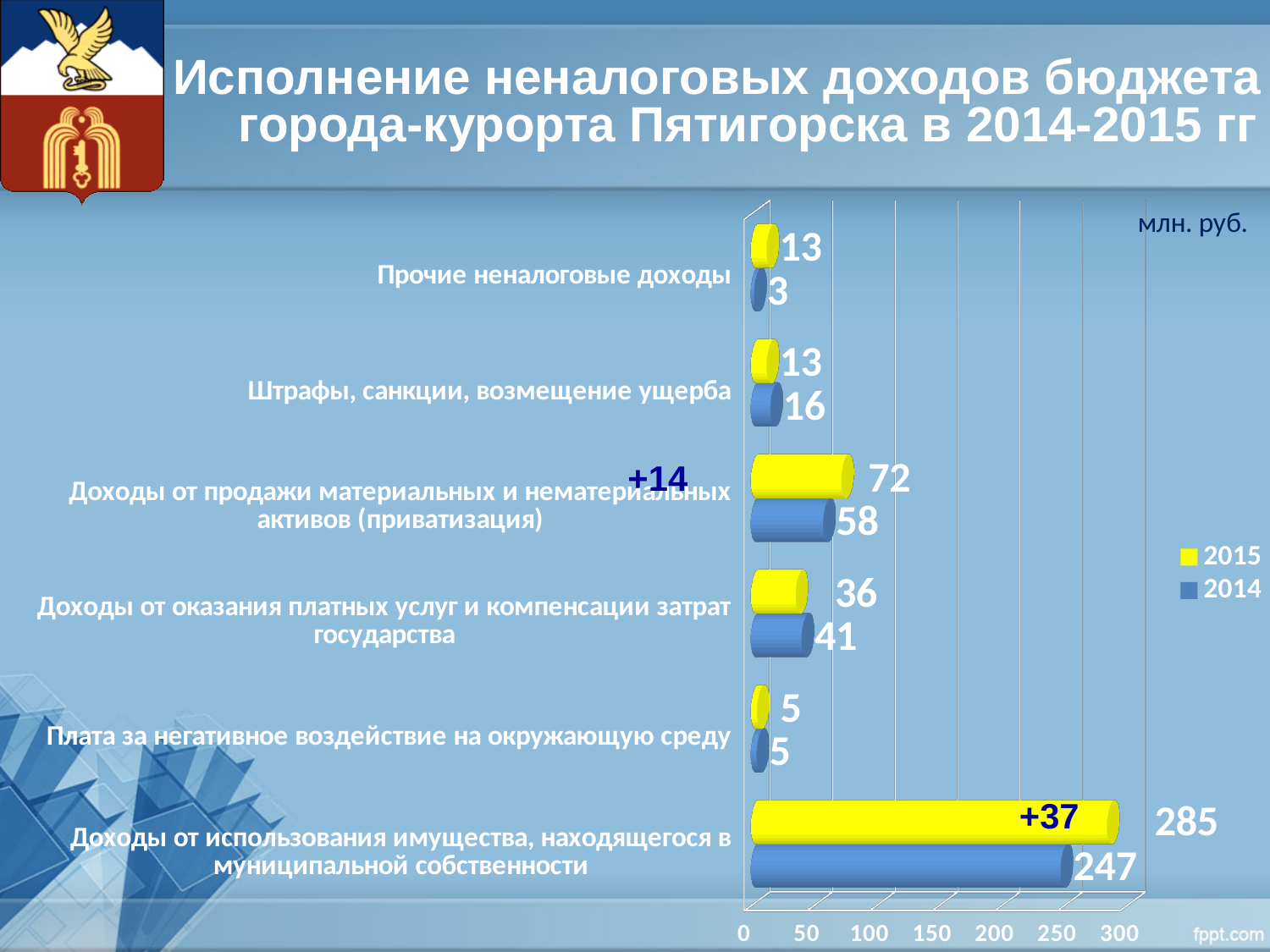
Which colour represents the 2015 series in the chart? yellow How many categories are shown on the chart? 6 What type of chart is shown on the slide? bar chart How many series does the chart legend list? 2 What is the 2014 value for «Прочие неналоговые доходы»? 3 Which category has the lowest 2014 value? Прочие неналоговые доходы Which category has the highest 2015 value? Доходы от использования имущества, находящегося в муниципальной собственности For «Доходы от оказания платных услуг и компенсации затрат государства», which year has the larger value, 2015 or 2014? 2014 What is the 2015 value for «Доходы от использования имущества, находящегося в муниципальной собственности»? 285 What is the 2014 value for «Доходы от продажи материальных и нематериальных активов (приватизация)»? 58 What is the difference between the 2015 and 2014 values for «Доходы от использования имущества, находящегося в муниципальной собственности»? 38 What unit is indicated for the values on the chart? млн. руб.